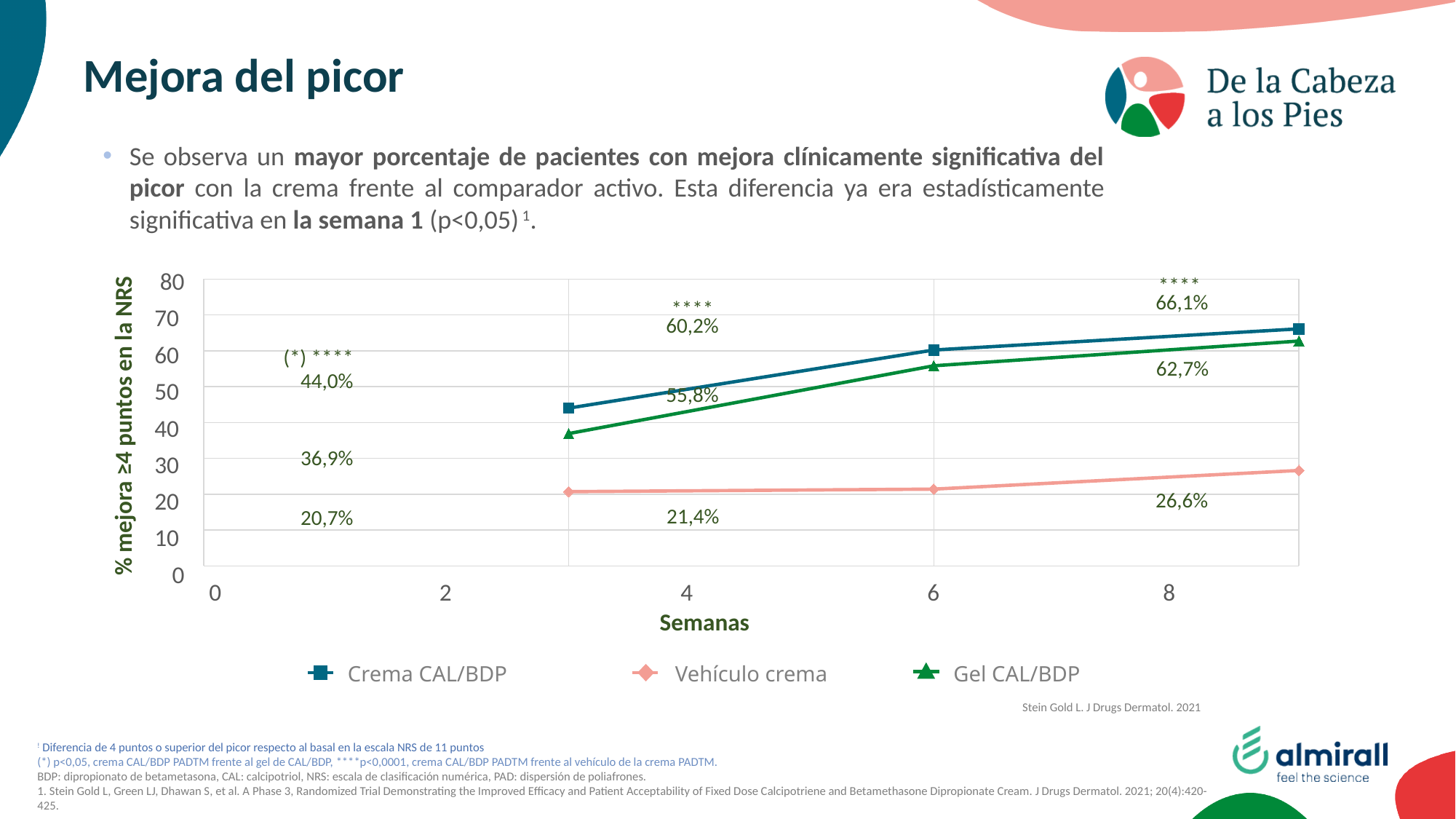
What is the value of the middle data point for Gel CAL/BDP? 55,8% How many data points are plotted for each series? 3 By how much does the Crema CAL/BDP value increase from its first data point (44,0%) to its last (66,1%)? 22,1 percentage points What is the value of the first data point for Vehículo crema? 20,7% What is the value of the last data point for Crema CAL/BDP? 66,1% Do the values for Vehículo crema rise or fall along the x axis? rise What is the title of the x axis? Semanas How many series does the legend list? 3 Which series has the lowest value at the final time point? Vehículo crema Which series has the highest value at the final time point? Crema CAL/BDP What is the difference between the final values of Crema CAL/BDP (66,1%) and Gel CAL/BDP (62,7%)? 3,4 percentage points What kind of chart is shown on the slide? line chart